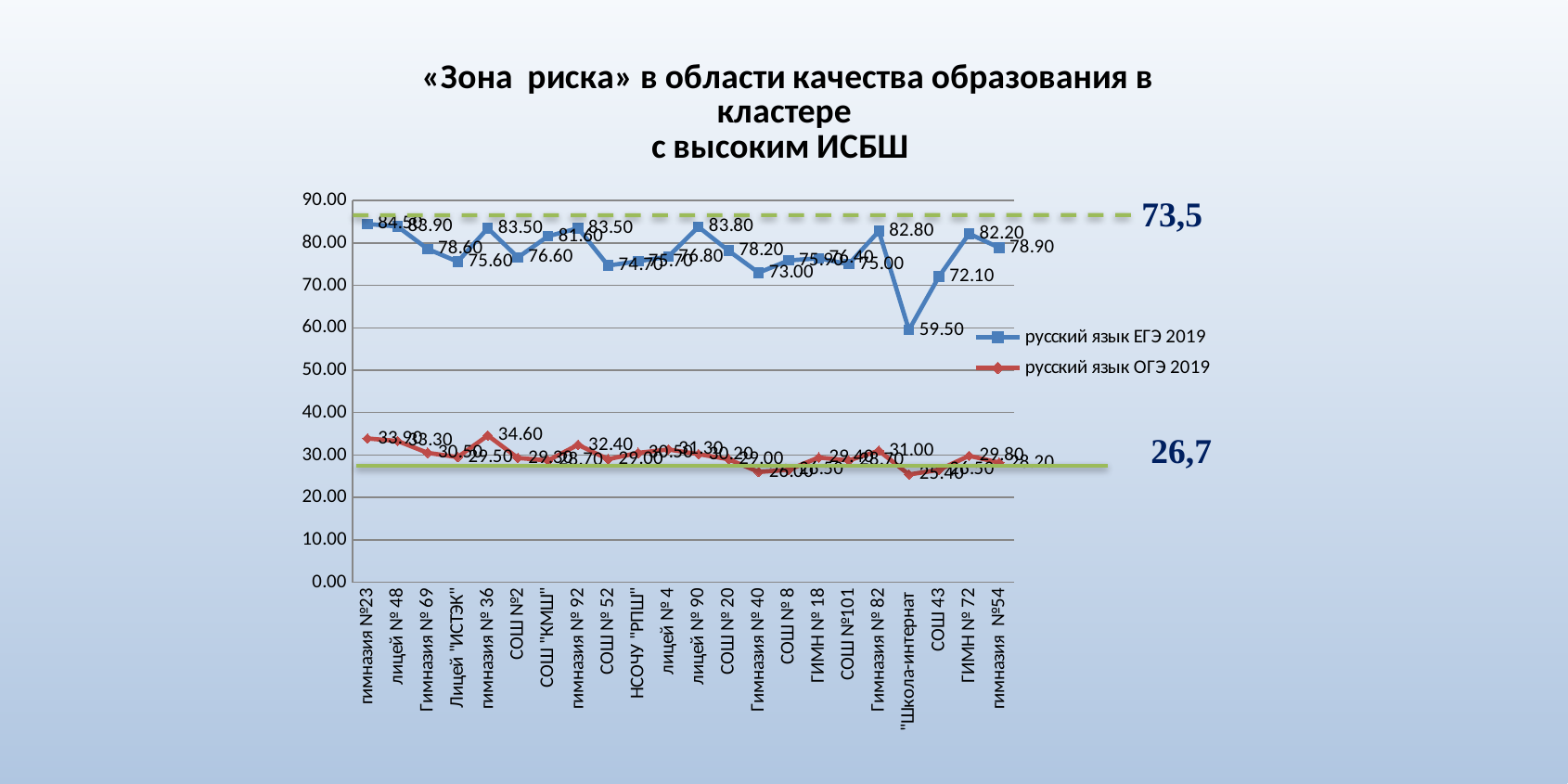
What is the value of русский язык ОГЭ 2019 for гимназия № 36? 34.60 What is the value of русский язык ЕГЭ 2019 for Гимназия № 82? 82.80 Which school has the lowest value for русский язык ЕГЭ 2019? "Школа-интернат What type of chart is shown on the slide? Line chart What is the value of русский язык ЕГЭ 2019 for "Школа-интернат"? 59.50 Which has the higher русский язык ЕГЭ 2019 value, СОШ 43 or ГИМН № 72? ГИМН № 72 What value is labelled on the dashed green reference line at the top of the chart? 73,5 What is the difference between the русский язык ЕГЭ 2019 values for Гимназия № 82 and "Школа-интернат"? 23.30 Is the русский язык ЕГЭ 2019 value for СОШ 43 greater or less than 80.00? less How many schools are plotted along the x axis? 22 Which school has the lowest value for русский язык ОГЭ 2019? "Школа-интернат How many series does the legend list? 2